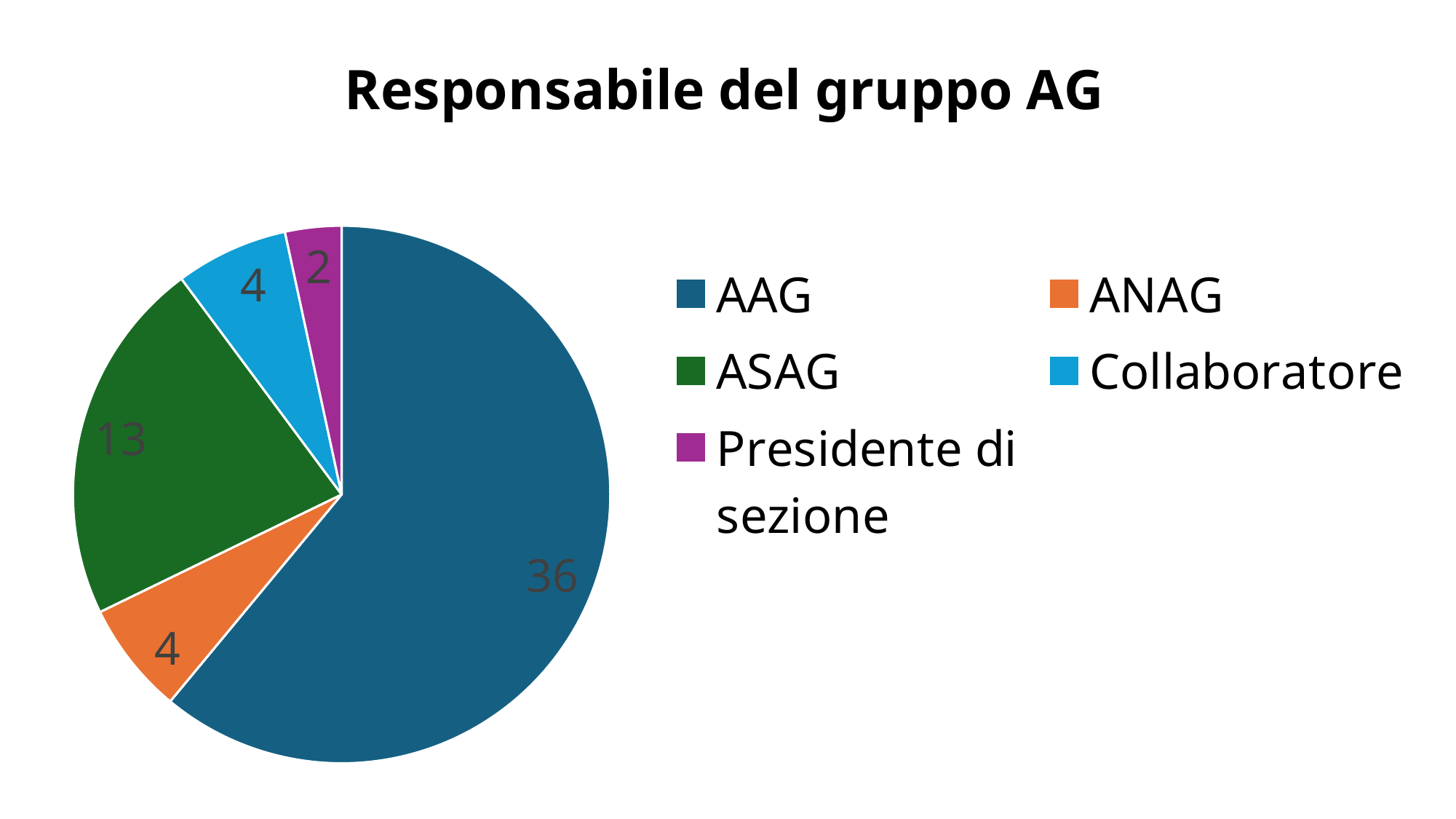
What is the value for Presidente di sezione? 2 Which category has the largest slice? AAG Which category has the smallest slice? Presidente di sezione What is the title of the chart? Responsabile del gruppo AG What is the total of all slices in the pie chart? 59 What type of chart is shown on the slide? pie chart What is the value for ASAG? 13 How many categories does the pie chart have? 5 What is the value for AAG? 36 Which is larger, the value for ASAG or the value for Collaboratore? ASAG What is the value for ANAG? 4 What is the difference between the values for AAG and ASAG? 23